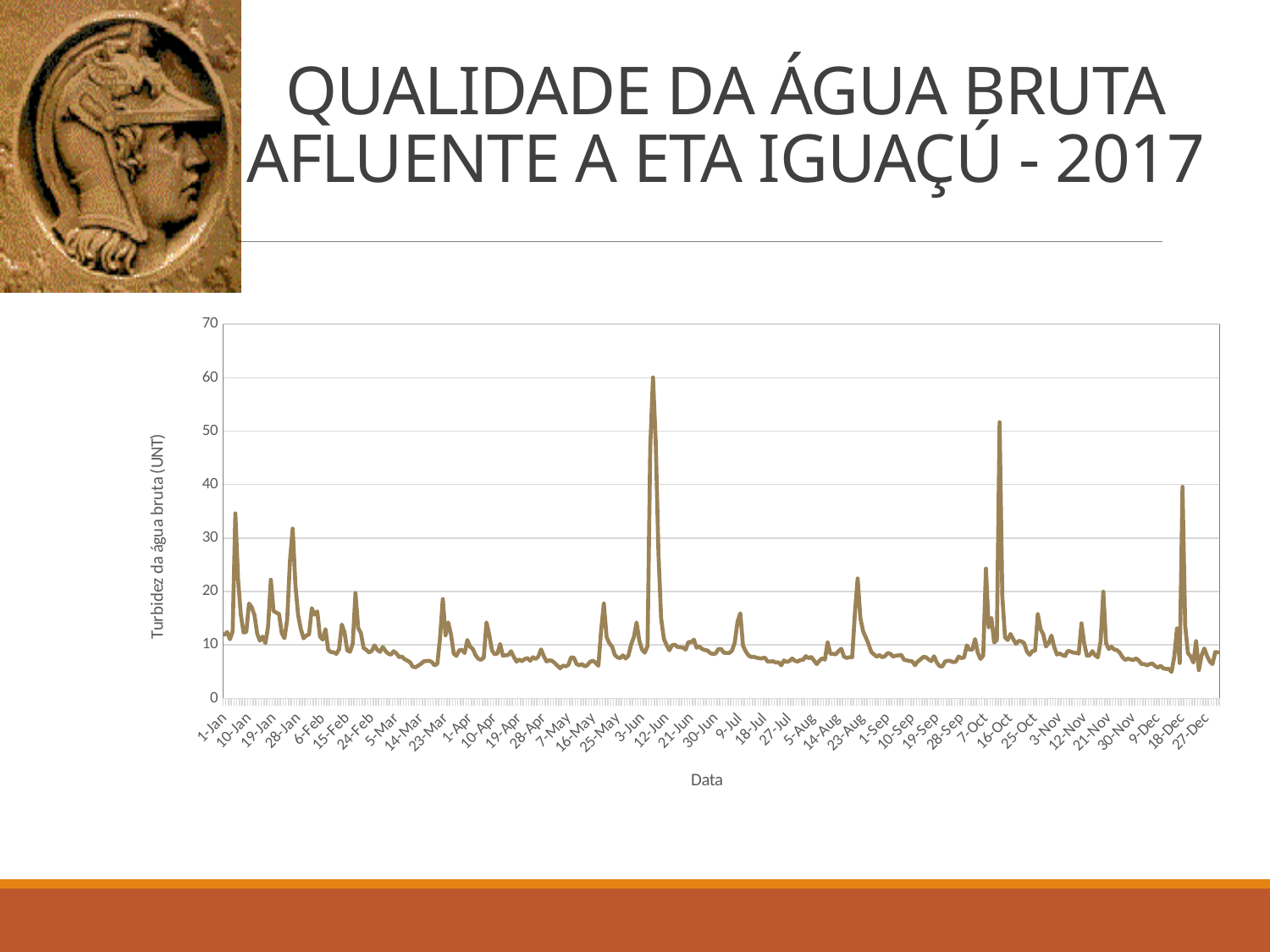
What is the title of the vertical axis of the chart? Turbidez da água bruta (UNT) Is the turbidity around 14-Mar greater or less than 10? less What is the title of the horizontal axis of the chart? Data Is the highest peak of turbidity, near 12-Jun, greater or less than 50? greater Is the peak of turbidity near 10-Jan greater or less than 30? greater Which is higher: the turbidity peak near 12-Jun or the peak near 16-Oct? 12-Jun Which is higher: the turbidity peak near 23-Aug or the peak near 18-Dec? 18-Dec What kind of chart is shown on the slide? line chart